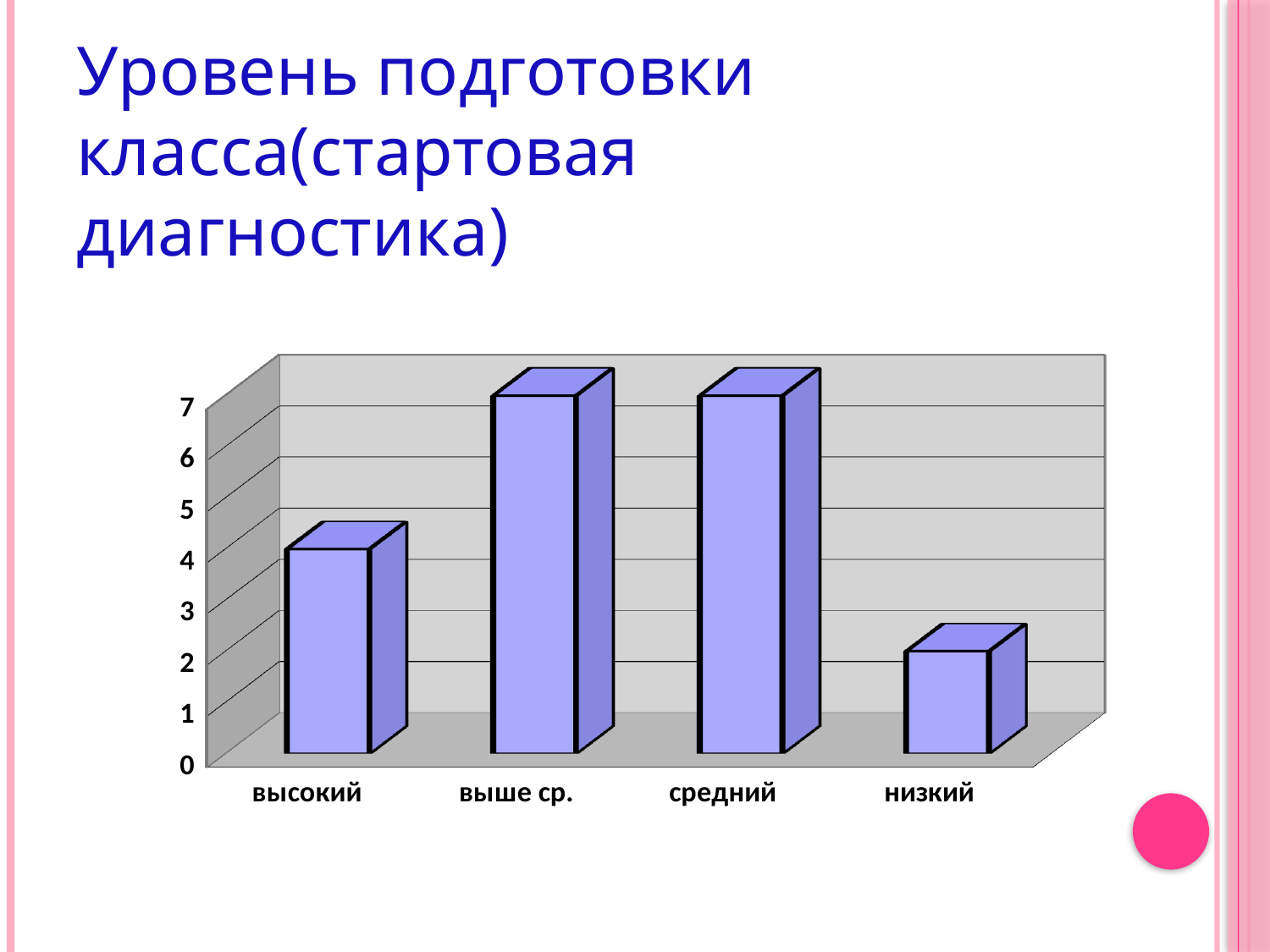
Is the value for выше ср. greater or less than 6? greater Is the value for высокий greater or less than 3? greater Is the value for низкий greater or less than 1? greater Which category has the lowest bar in the chart? низкий Which is larger, the value for высокий or the value for низкий? высокий What is the title of the slide containing the chart? Уровень подготовки класса(стартовая диагностика) What kind of chart is shown on the slide? bar chart How many categories are shown on the x axis of the chart? 4 Which is larger, the value for выше ср. or the value for высокий? выше ср.